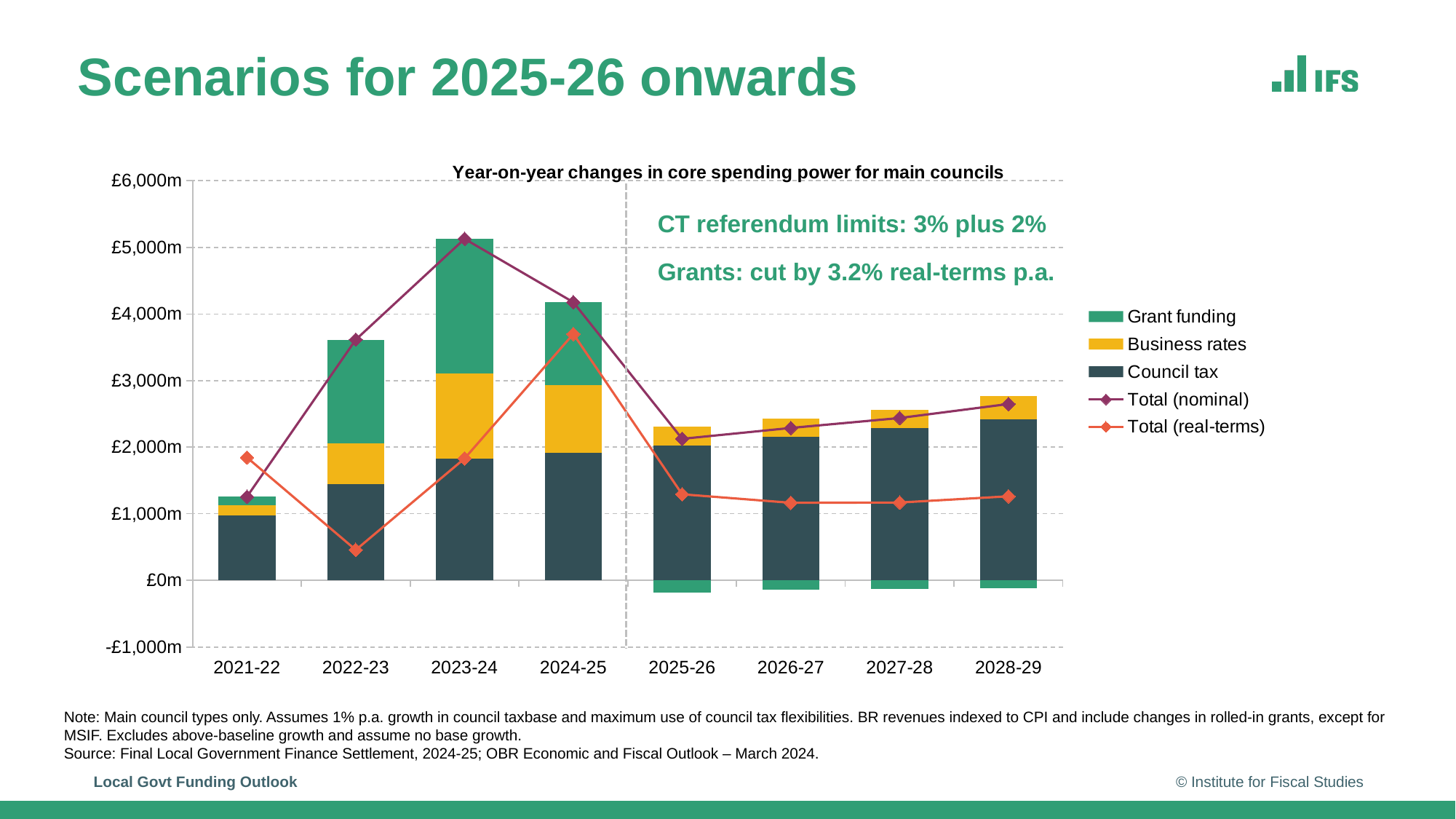
What is the title of the chart? Year-on-year changes in core spending power for main councils In 2024-25, which is larger: Total (nominal) or Total (real-terms)? Total (nominal) In which year is Total (nominal) highest? 2023-24 How many years are shown on the x axis? 8 Is the Total (real-terms) value for 2022-23 greater or less than £1,000m? less Is the Council tax value for 2028-29 greater or less than £2,000m? greater Does Total (nominal) rise or fall from 2025-26 to 2028-29? Rise In which year is Total (real-terms) lowest? 2022-23 How many series does the legend list? 5 Is the Total (nominal) value for 2022-23 greater or less than £3,000m? greater What kind of chart is shown on the slide? A stacked bar chart with line series